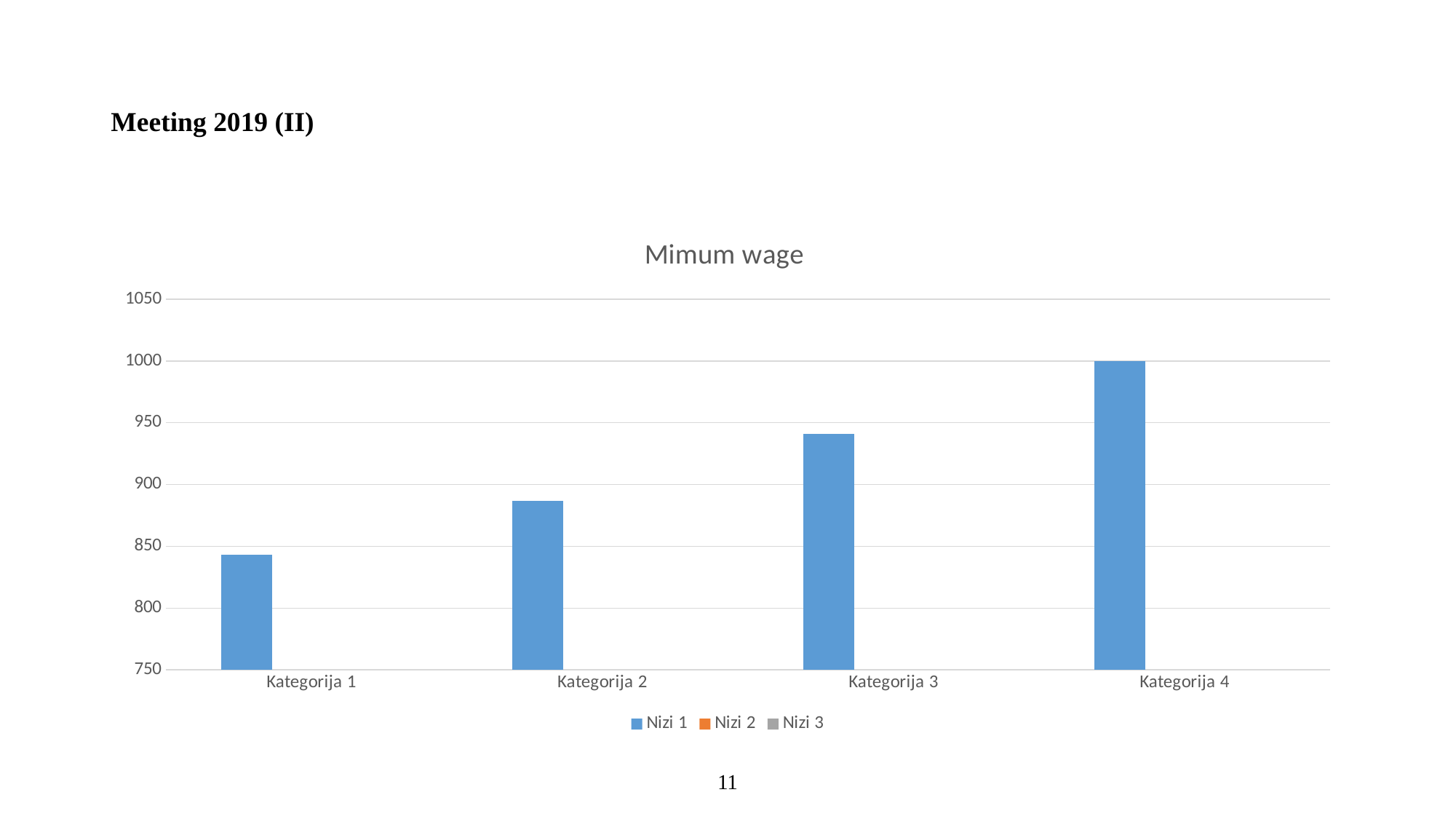
Is the value for Kategorija 3 greater or less than 950? less How many series does the legend of the chart list? 3 Do the values rise or fall from Kategorija 1 to Kategorija 4? rise Is the value for Kategorija 2 greater or less than 850? greater Which category has the highest value in the chart? Kategorija 4 How many categories are shown on the x axis of the chart? 4 Which category has the lowest value in the chart? Kategorija 1 Is the value for Kategorija 3 greater or less than 900? greater What kind of chart is shown on the slide? bar chart What is the title of the chart? Mimum wage Which is larger, the value for Kategorija 2 or the value for Kategorija 3? Kategorija 3